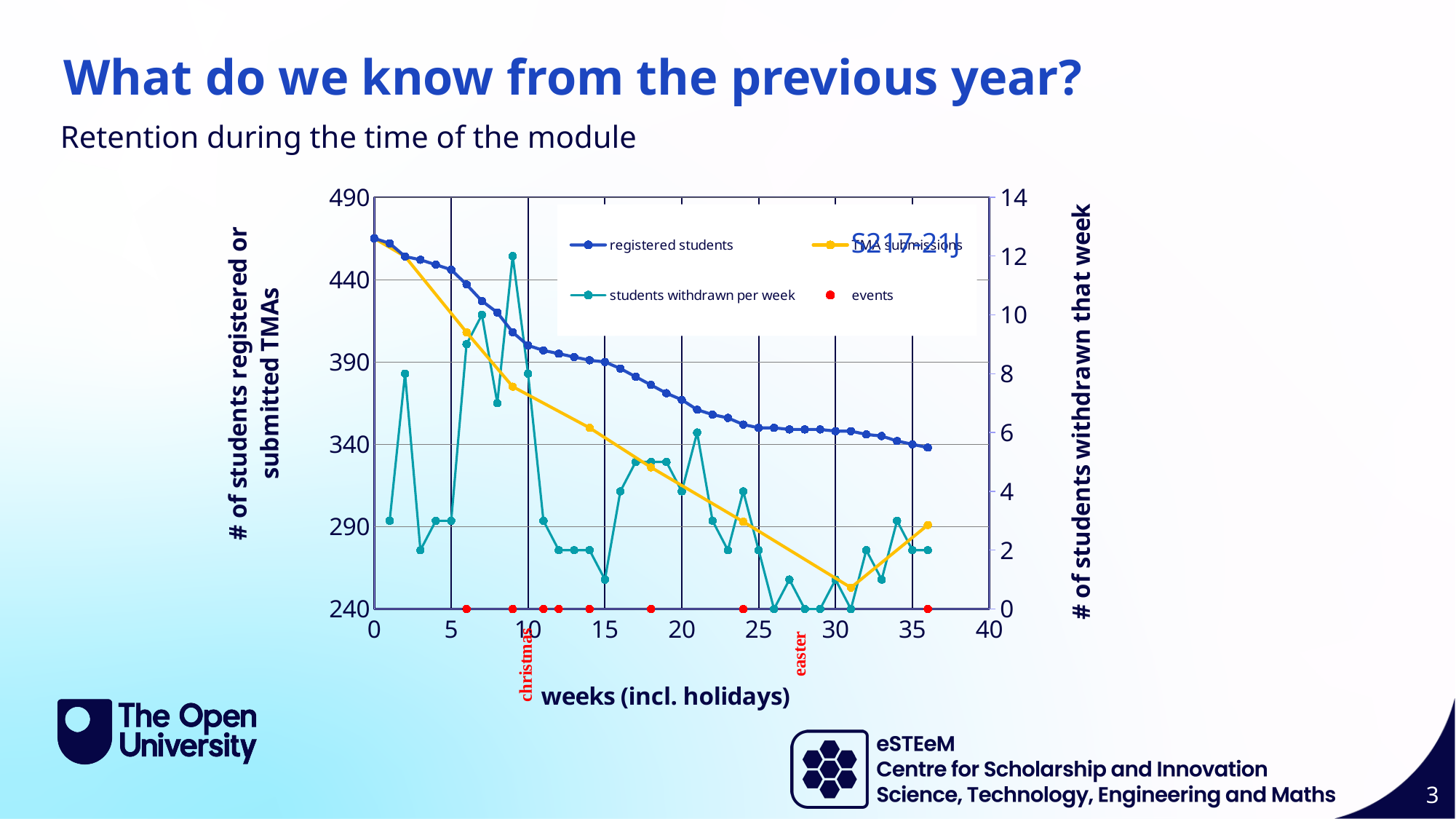
Which week has more students withdrawn: week 9 or week 2? week 9 How many series does the chart legend list? 4 In which week is the number of students withdrawn per week highest? week 9 Which two holidays are annotated in red below the x axis? christmas and easter Does the number of registered students rise or fall over the weeks of the module? fall Is the number of registered students at week 36 greater or less than 390? less Is the number of students withdrawn in week 9 greater or less than 10? greater Is the number of registered students at week 0 greater or less than 440? greater Which is larger: the number of registered students at week 0 or at week 36? week 0 What kind of chart is shown on the slide? line chart What is the title of the x axis of the chart? weeks (incl. holidays)